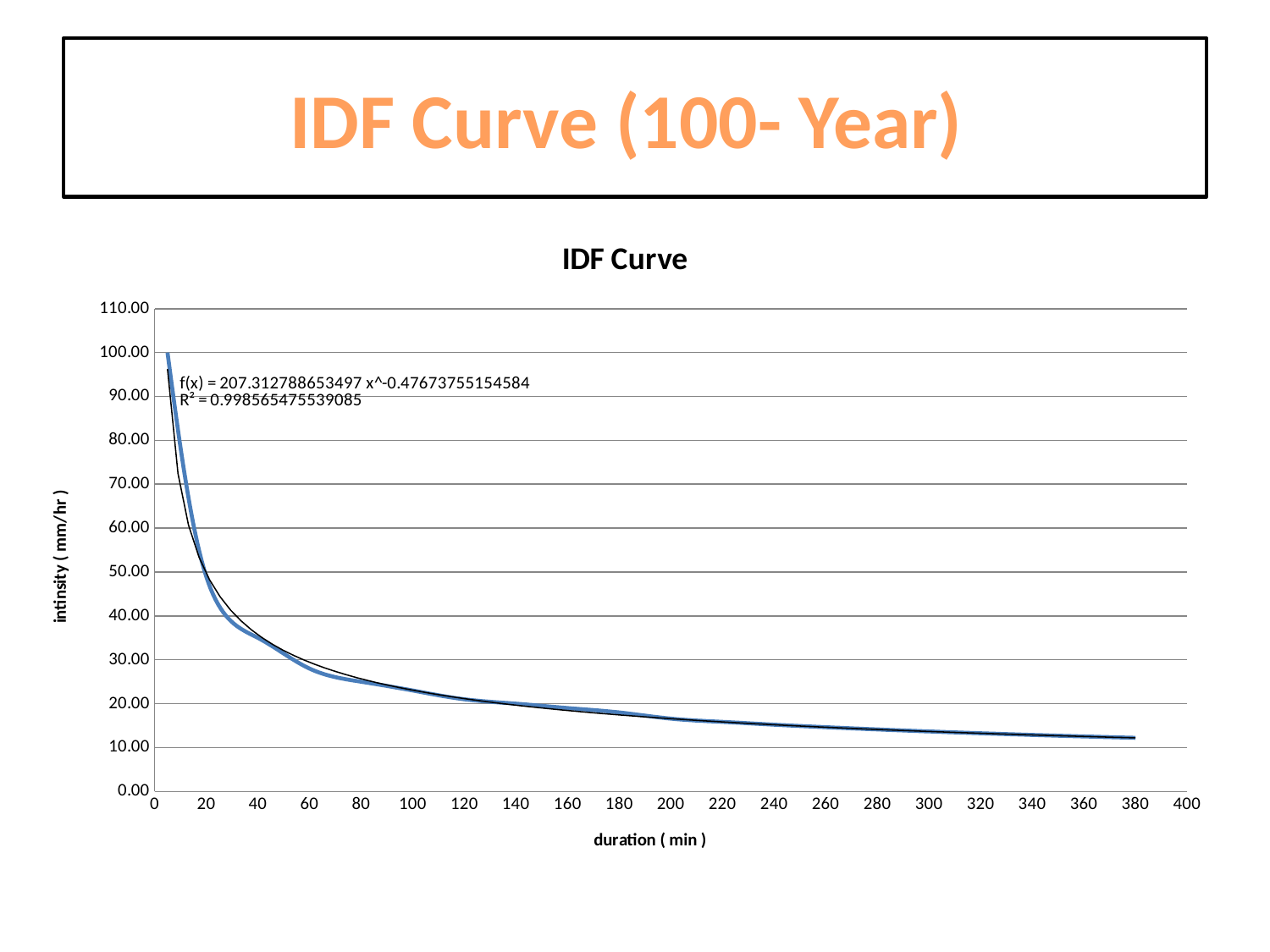
Is the intensity at a duration of 380 min greater or less than 20? less Is the intensity at a duration of 40 min greater or less than 30? greater What is the label of the x axis? duration ( min ) Do the intensity values rise or fall as duration increases along the x axis? fall What kind of chart is shown on the slide? line chart Is the intensity at a duration of 200 min greater or less than 20? less What is the title of the chart? IDF Curve What is the highest value shown on the y axis? 110.00 Which duration has the higher intensity, 20 min or 100 min? 20 min